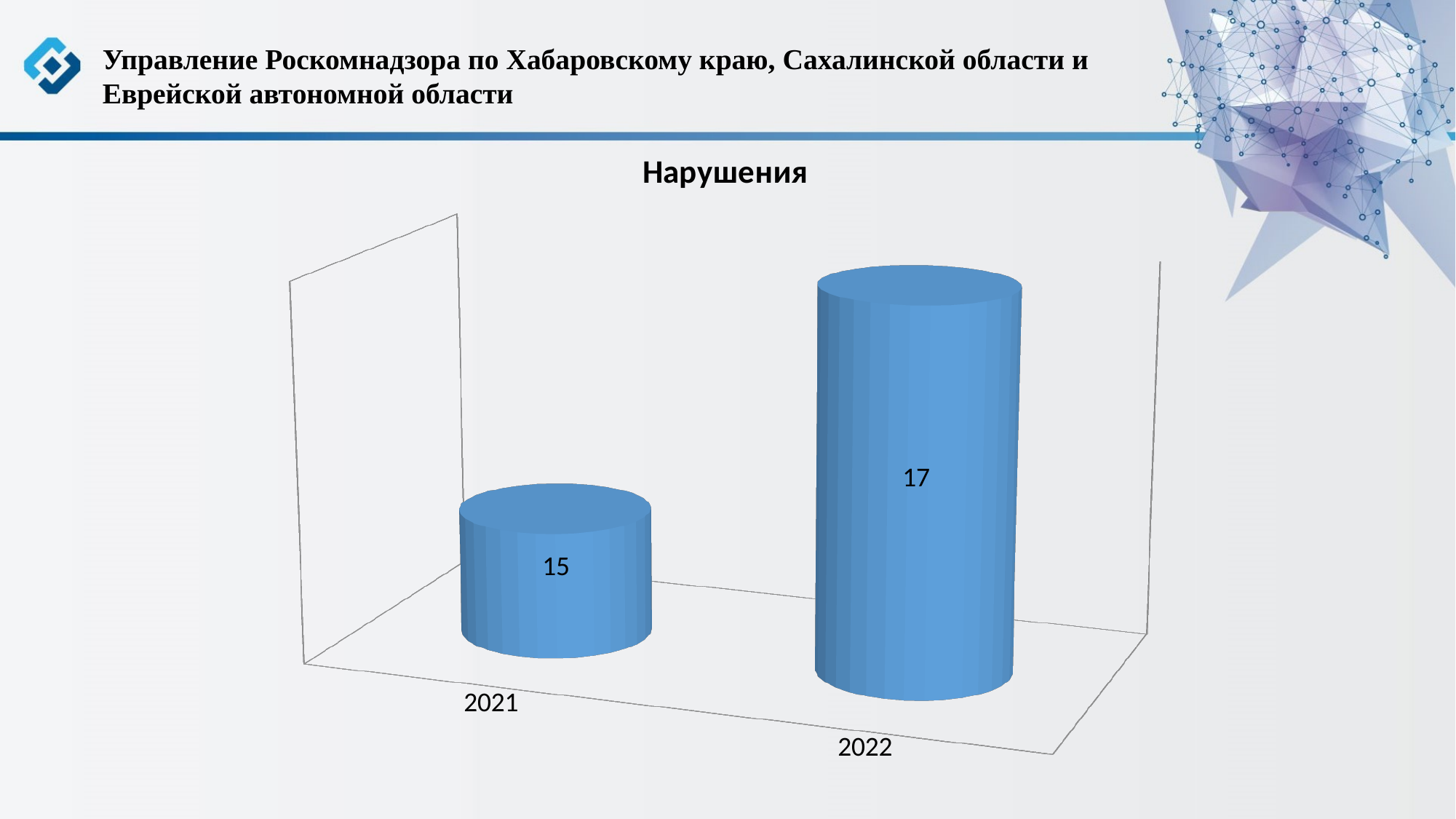
What is the value for 2022 in the chart? 17 What kind of chart is shown on the slide? Bar chart Which year has the lowest value in the chart? 2021 What is the value for 2021 in the chart? 15 Do the values rise or fall from 2021 to 2022? Rise Which year has the highest value in the chart? 2022 What colour are the bars in the chart? Blue Which is larger, the value for 2021 or the value for 2022? 2022 What is the title of the chart? Нарушения How many categories are shown in the chart? 2 What is the difference between the values for 2022 and 2021? 2